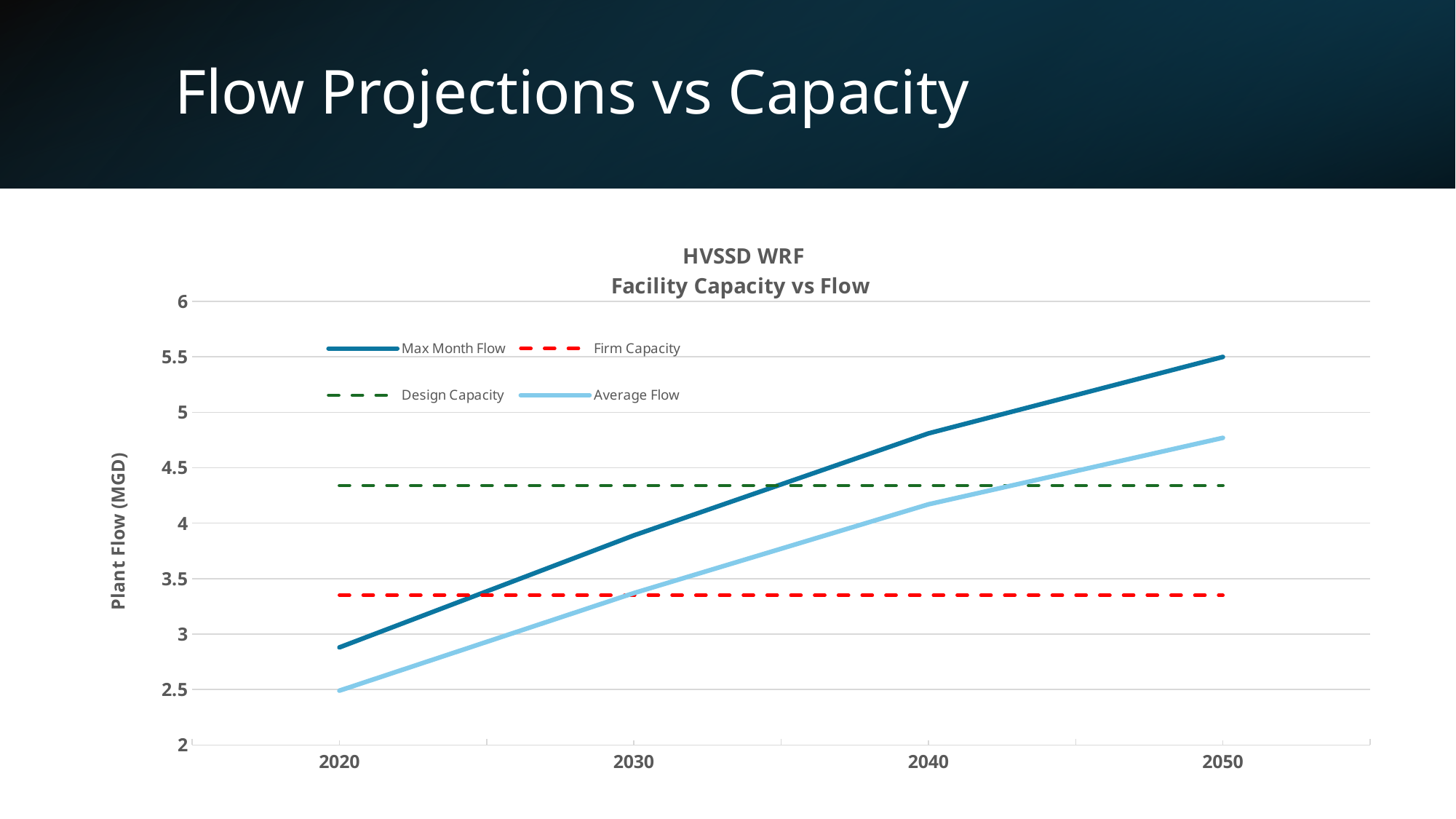
Is the Firm Capacity line greater or less than 3.5? less Does the Max Month Flow series rise or fall from 2020 to 2050? rise How many series does the chart legend list? 4 Is the Max Month Flow value for 2040 greater or less than 4.5? greater Is the Max Month Flow value for 2020 greater or less than 3? less How many years are labelled on the x axis of the chart? 4 In 2050, which is higher: Max Month Flow or Average Flow? Max Month Flow What is the label on the y axis of the chart? Plant Flow (MGD) What kind of chart is shown on the slide? line chart Which is higher: Design Capacity or Firm Capacity? Design Capacity